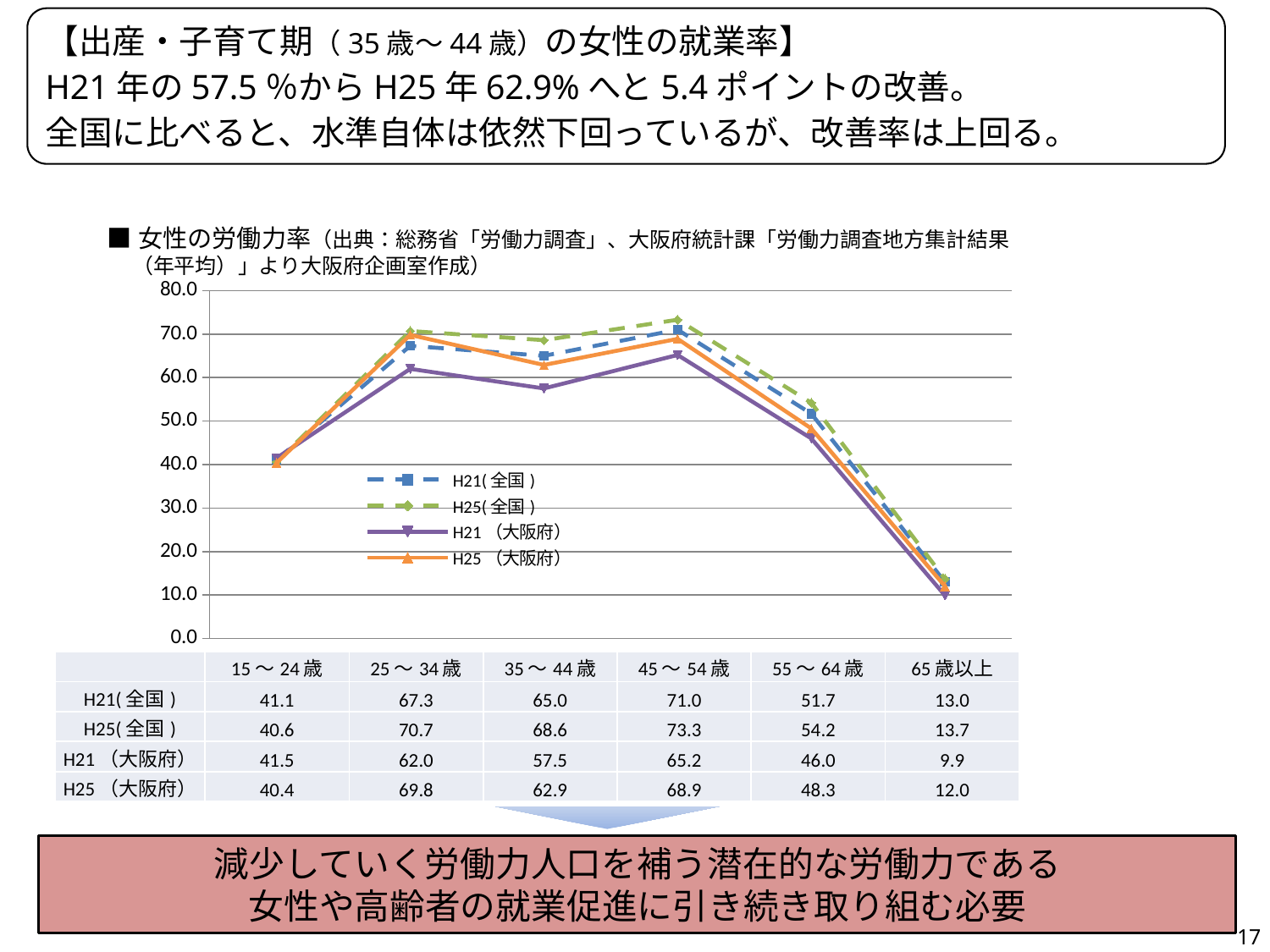
What is the difference between H25（大阪府） and H21（大阪府） in the 35～44歳 category? 5.4 Which age category has the lowest value for the H21（大阪府） series? 65歳以上 How many age categories are plotted along the x axis? 6 What is the value for H25（大阪府） in the 35～44歳 category? 62.9 Which age category has the highest value for the H25(全国) series? 45～54歳 What is the value for H21(全国) in the 45～54歳 category? 71.0 How many series does the chart legend list? 4 In the 25～34歳 category, which is larger: H25(全国) or H25（大阪府）? H25(全国) Is the value for H21（大阪府） in the 55～64歳 category greater or less than 50.0? less What is the value for H21（大阪府） in the 65歳以上 category? 9.9 Which series is drawn with a green dashed line in the chart? H25(全国) What type of chart is shown on the slide? Line chart